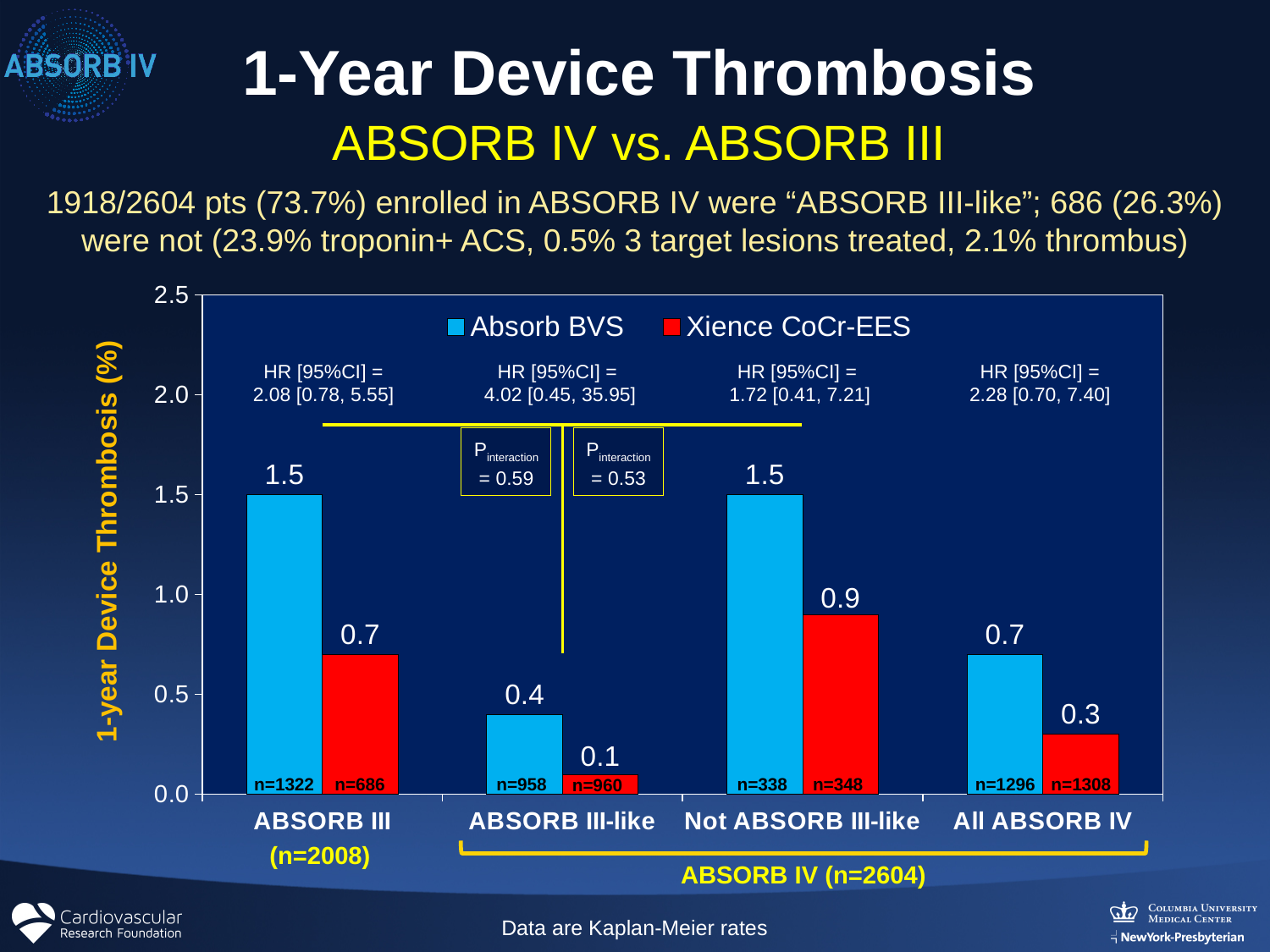
What is the difference between the Absorb BVS and Xience CoCr-EES rates in the Not ABSORB III-like group? 0.6 What is the 1-year device thrombosis rate for Xience CoCr-EES in the Not ABSORB III-like group? 0.9 Which group has the lowest Xience CoCr-EES device thrombosis rate? ABSORB III-like What is the difference between the Absorb BVS and Xience CoCr-EES rates in the All ABSORB IV group? 0.4 What type of chart is shown on the slide? Bar chart What is the 1-year device thrombosis rate for Absorb BVS in the ABSORB III group? 1.5 Which group has the lowest Absorb BVS device thrombosis rate? ABSORB III-like How many groups are shown on the x axis of the chart? 4 What is the 1-year device thrombosis rate for Xience CoCr-EES in the ABSORB III-like group? 0.1 In the ABSORB III group, which series has the higher device thrombosis rate, Absorb BVS or Xience CoCr-EES? Absorb BVS What is the 1-year device thrombosis rate for Absorb BVS in the All ABSORB IV group? 0.7 How many series does the chart legend list? 2